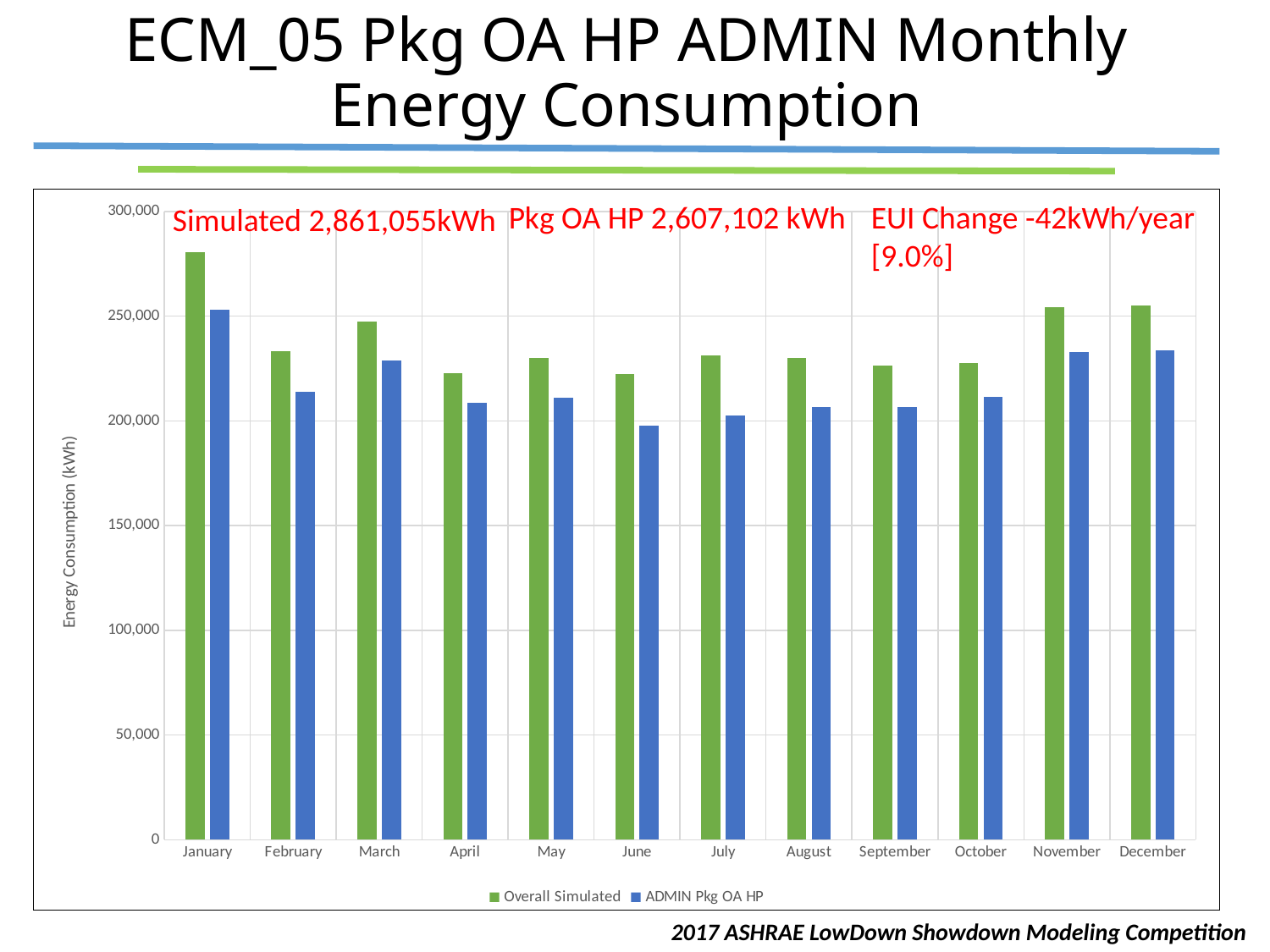
Is the Overall Simulated value for January greater or less than 250,000? greater Does the ADMIN Pkg OA HP value rise or fall from September to November? rise Which month has the lowest ADMIN Pkg OA HP value? June How many series does the legend list? 2 What kind of chart is shown on the slide? bar chart Which month has the highest Overall Simulated value? January Which month has the highest ADMIN Pkg OA HP value? January In January, which is larger: Overall Simulated or ADMIN Pkg OA HP? Overall Simulated What is the label on the y axis? Energy Consumption (kWh) How many months are shown on the x axis? 12 Is the ADMIN Pkg OA HP value for November greater or less than 200,000? greater